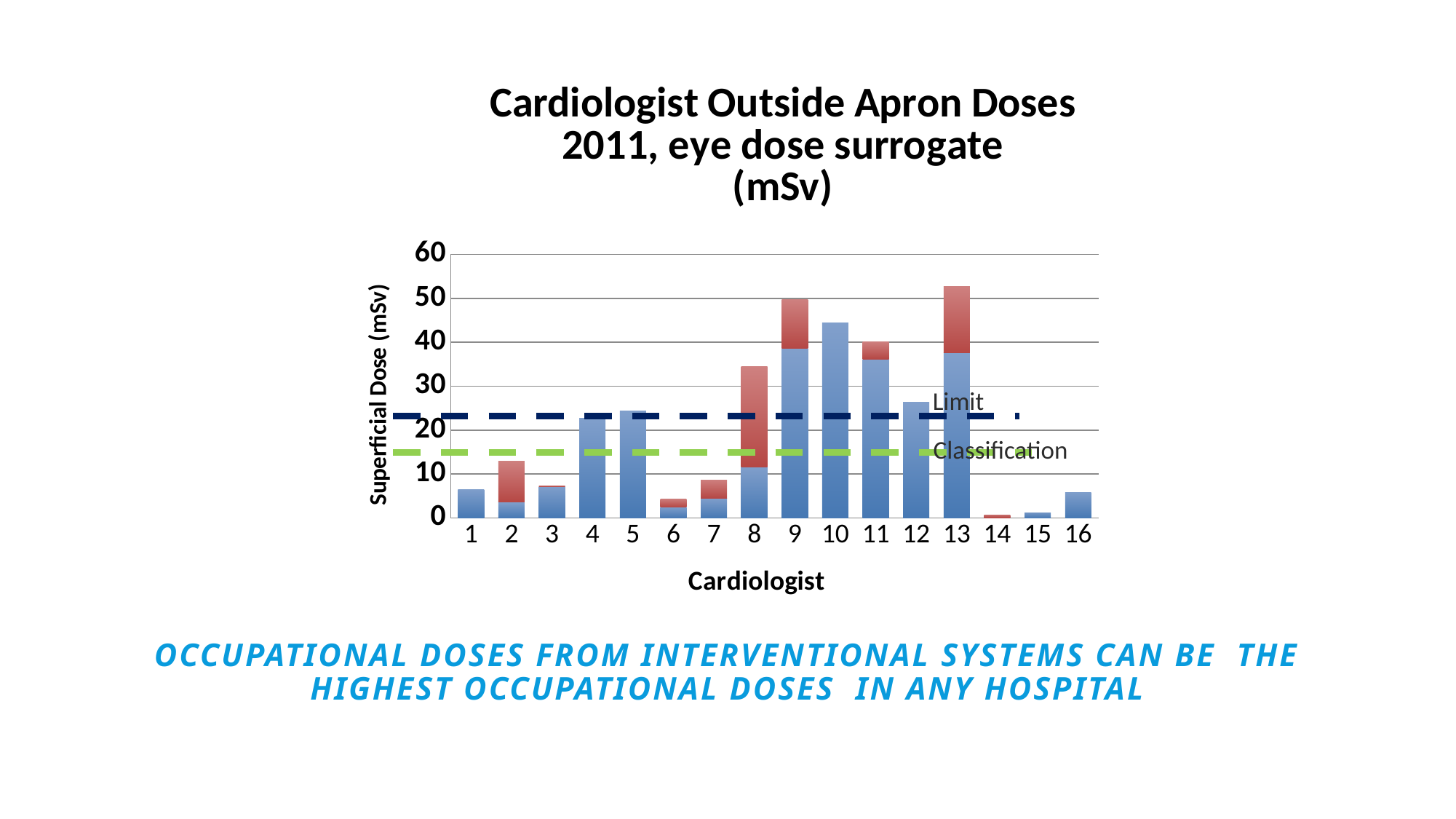
What are the two dashed reference lines on the chart labelled? Limit and Classification Which has the larger total dose, cardiologist 4 or cardiologist 6? Cardiologist 4 How many cardiologists are shown on the x axis of the chart? 16 Is the total dose for cardiologist 8 greater or less than 30 mSv? greater Is the total dose for cardiologist 16 greater or less than 10 mSv? less Is the total dose for cardiologist 10 greater or less than 40 mSv? greater Which cardiologist has the highest total superficial dose? 13 What kind of chart is shown on the slide? Bar chart Which has the larger total dose, cardiologist 10 or cardiologist 12? Cardiologist 10 Which cardiologist has the lowest total superficial dose? 14 What is the title of the y axis of the chart? Superficial Dose (mSv)